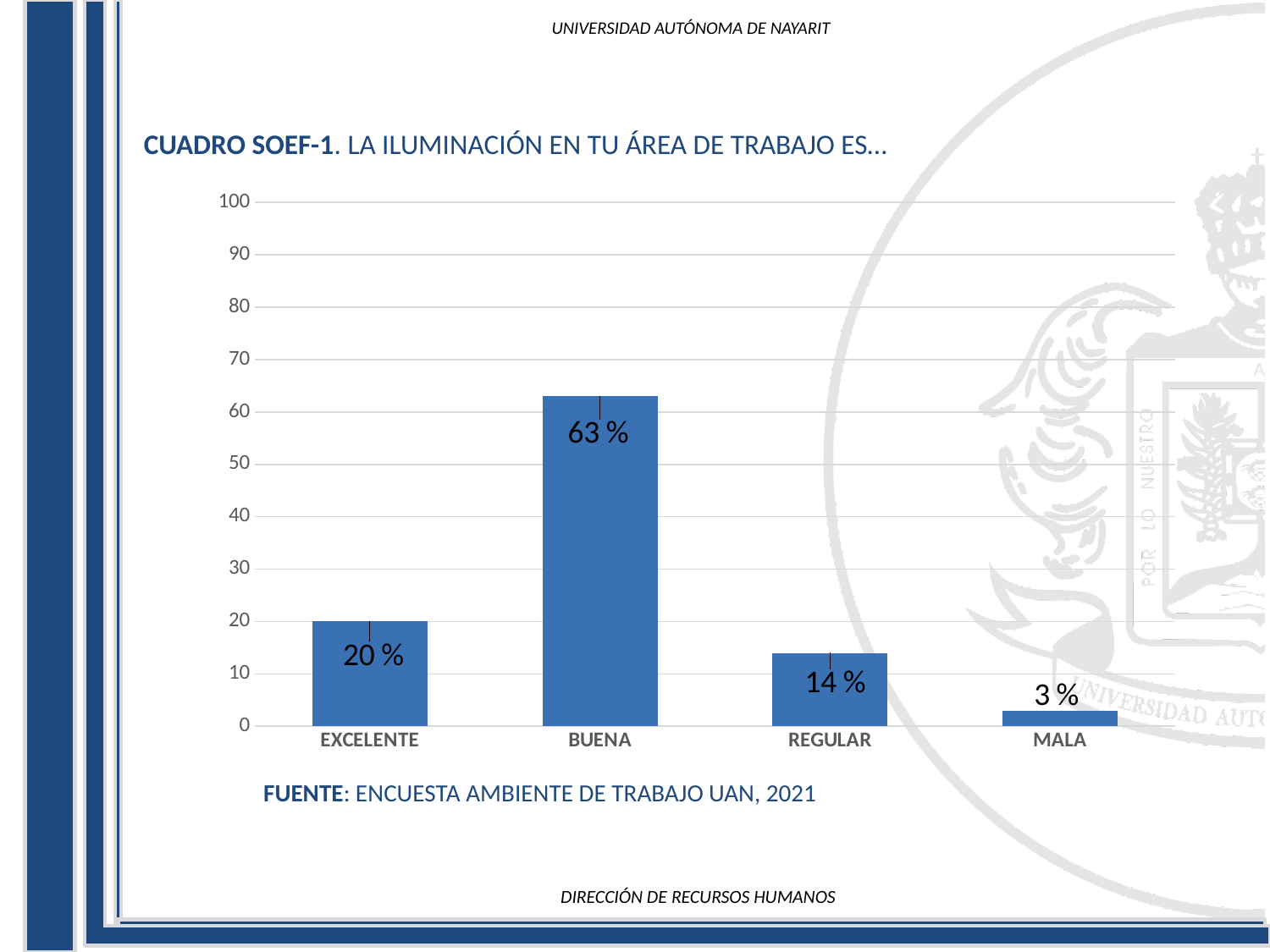
Is the value for BUENA greater or less than 50? greater Which is larger, the value for EXCELENTE or the value for REGULAR? EXCELENTE Which category has the highest value? BUENA What is the value for BUENA? 63 % What is the value for EXCELENTE? 20 % Which category has the lowest value? MALA How many categories are shown on the x axis? 4 What is the value for MALA? 3 % What is the difference between the values for BUENA and EXCELENTE? 43 % What kind of chart is shown on the slide? bar chart What is the value for REGULAR? 14 % What source is cited below the chart? ENCUESTA AMBIENTE DE TRABAJO UAN, 2021